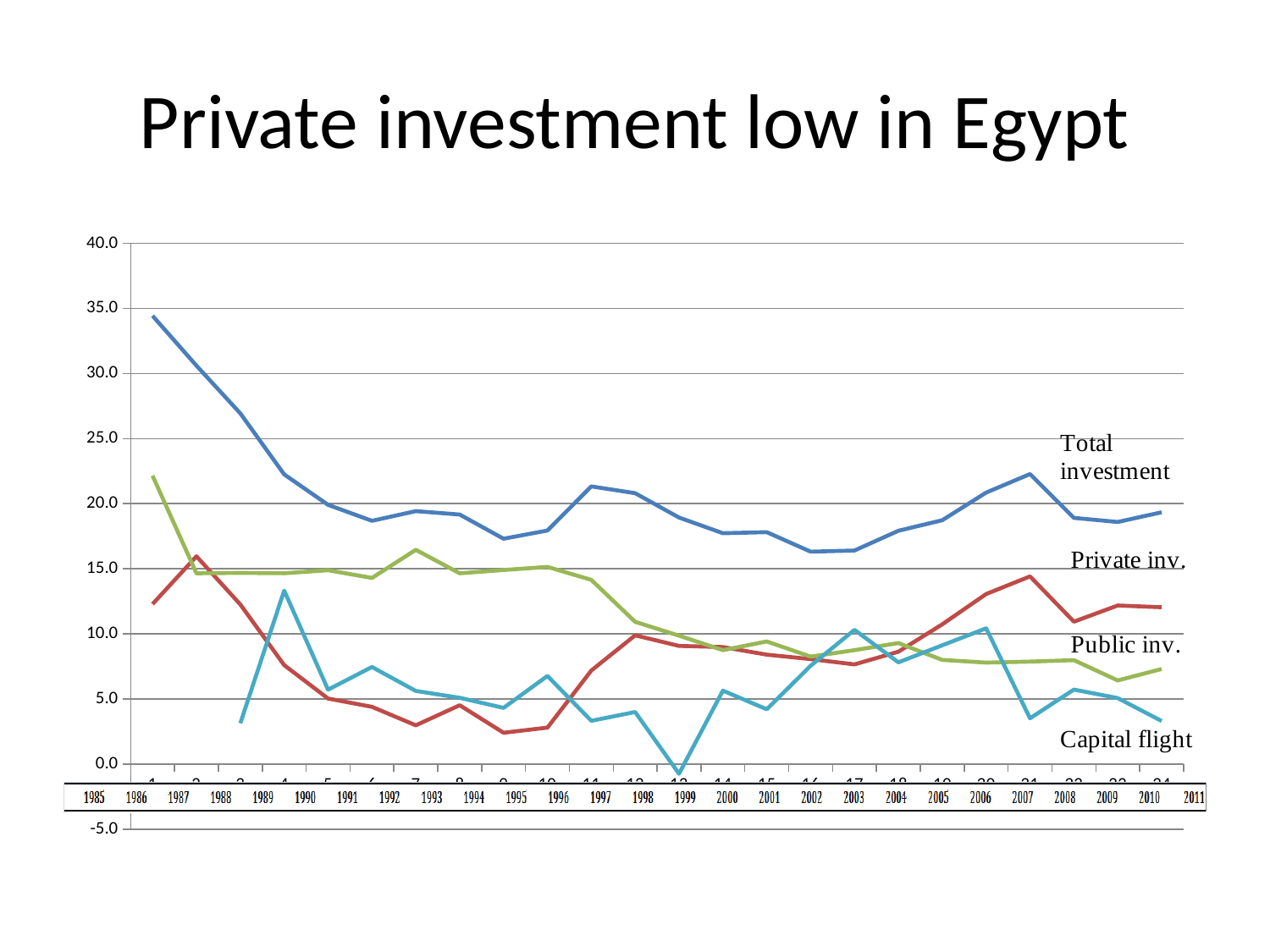
Is the value of Total investment in 2002 greater or less than 20? less Is the value of Total investment in 1986 greater or less than 30? greater Which series has the lowest value in 2010? Capital flight Which series has the highest value in 1986? Total investment What is the title of the slide? Private investment low in Egypt How many data series are plotted on the chart? 4 In 1986, which is larger: Public inv. or Private inv.? Public inv. In 2007, which is larger: Private inv. or Public inv.? Private inv. What kind of chart is shown on the slide? line chart Does Total investment rise or fall overall from 1986 to 2010? fall Is the value of Public inv. in 1986 greater or less than 20? greater